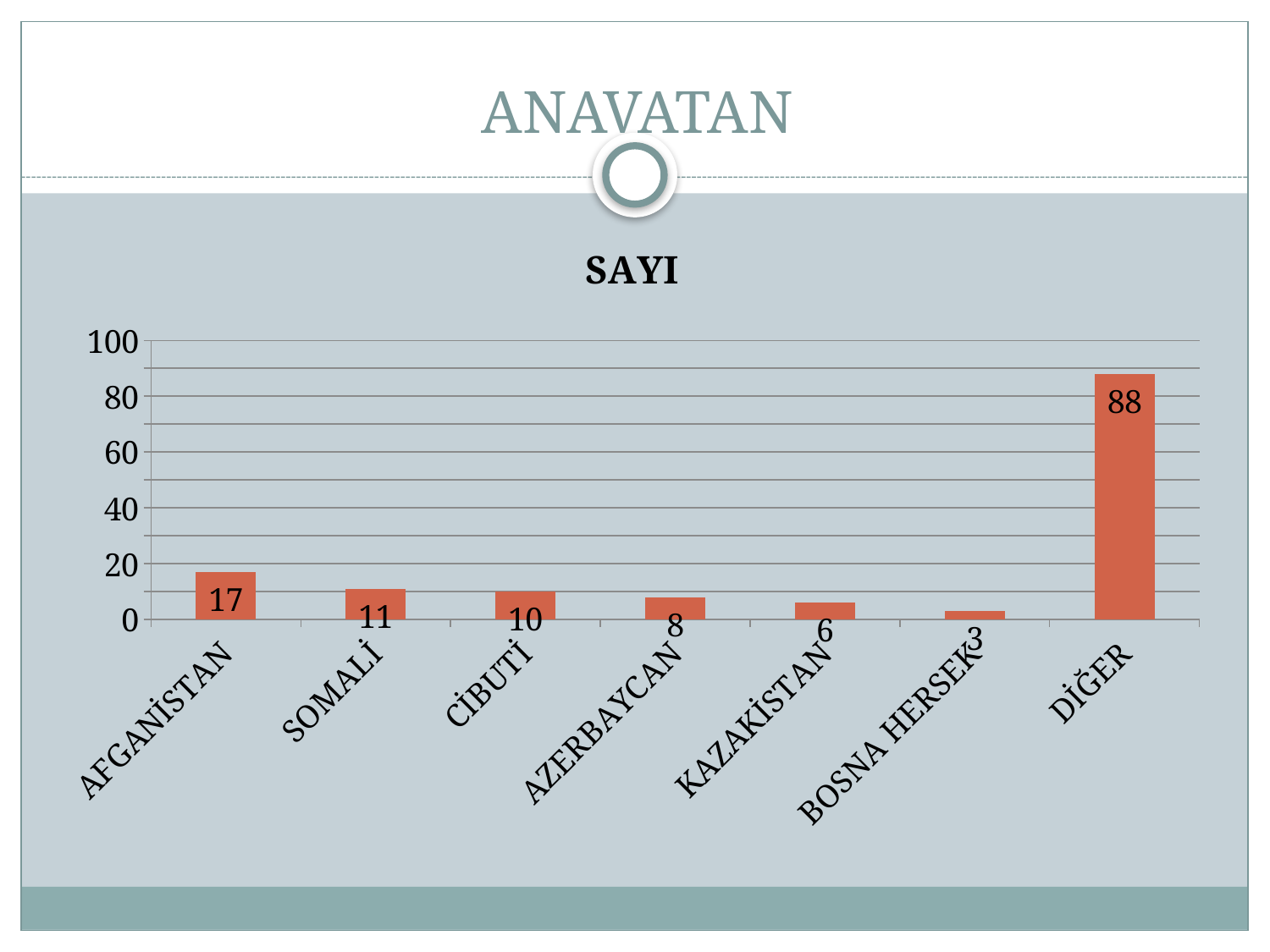
What is the value for SOMALİ? 11 Which is larger, the value for AZERBAYCAN or the value for KAZAKİSTAN? AZERBAYCAN What kind of chart is shown on the slide? bar chart What is the value for DİĞER? 88 How many categories are shown on the x axis? 7 What is the difference between the values for DİĞER and AFGANİSTAN? 71 What is the value for BOSNA HERSEK? 3 What is the value for AFGANİSTAN? 17 Is the value for DİĞER greater or less than 80? greater What is the difference between the values for CİBUTİ and KAZAKİSTAN? 4 Which category has the highest value? DİĞER Which category has the lowest value? BOSNA HERSEK